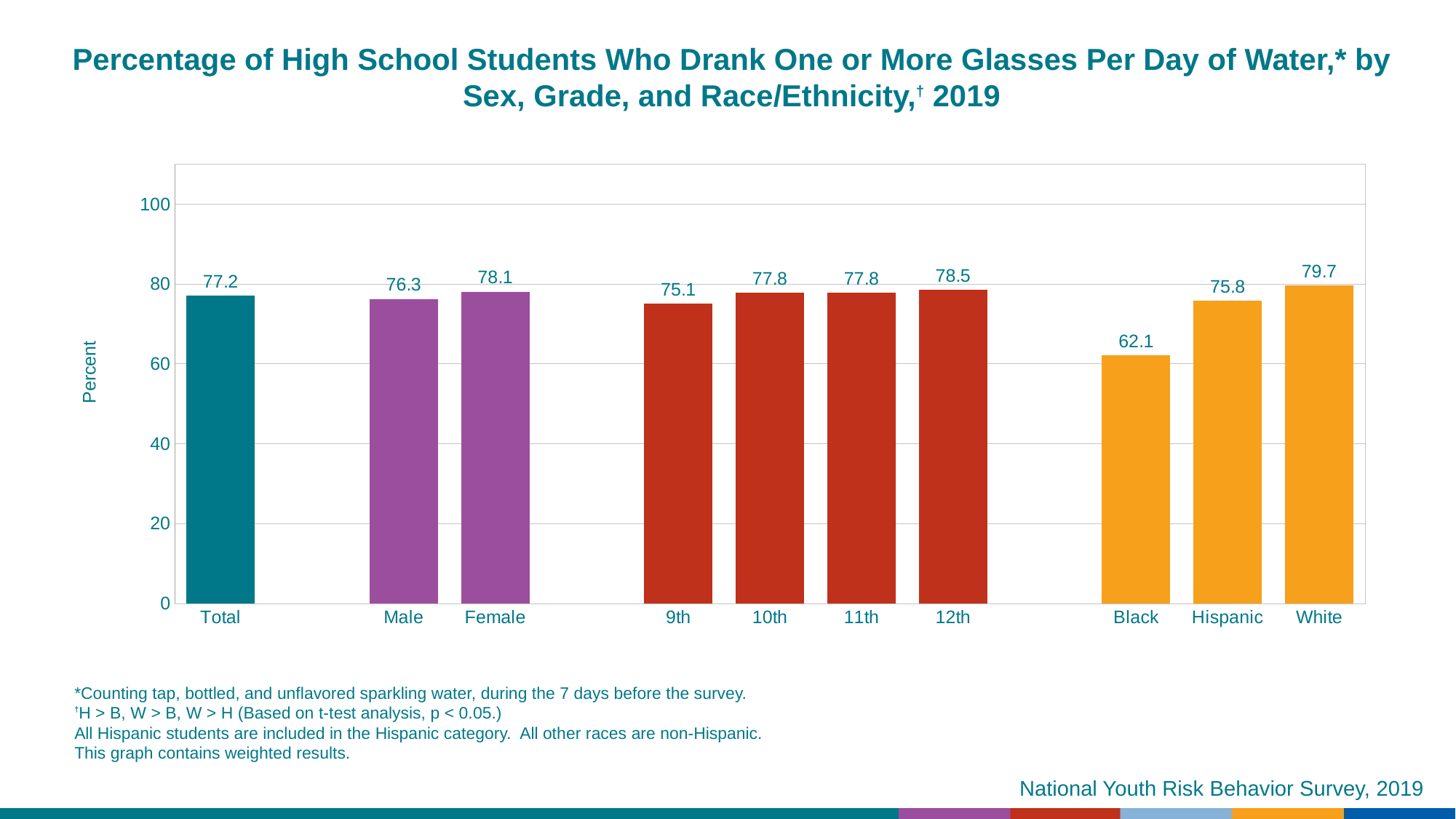
Which category has the highest value? White Which is larger, the value for Hispanic or the value for Black? Hispanic What kind of chart is shown on the slide? bar chart What is the value for 12th grade? 78.5 How many bars are shown in the chart? 10 What is the difference between the values for White and Black? 17.6 What is the difference between the values for Female and Male? 1.8 Is the value for Black greater or less than 80? less What is the value for Total? 77.2 What is the label of the y axis? Percent Which category has the lowest value? Black What is the value for Black students? 62.1